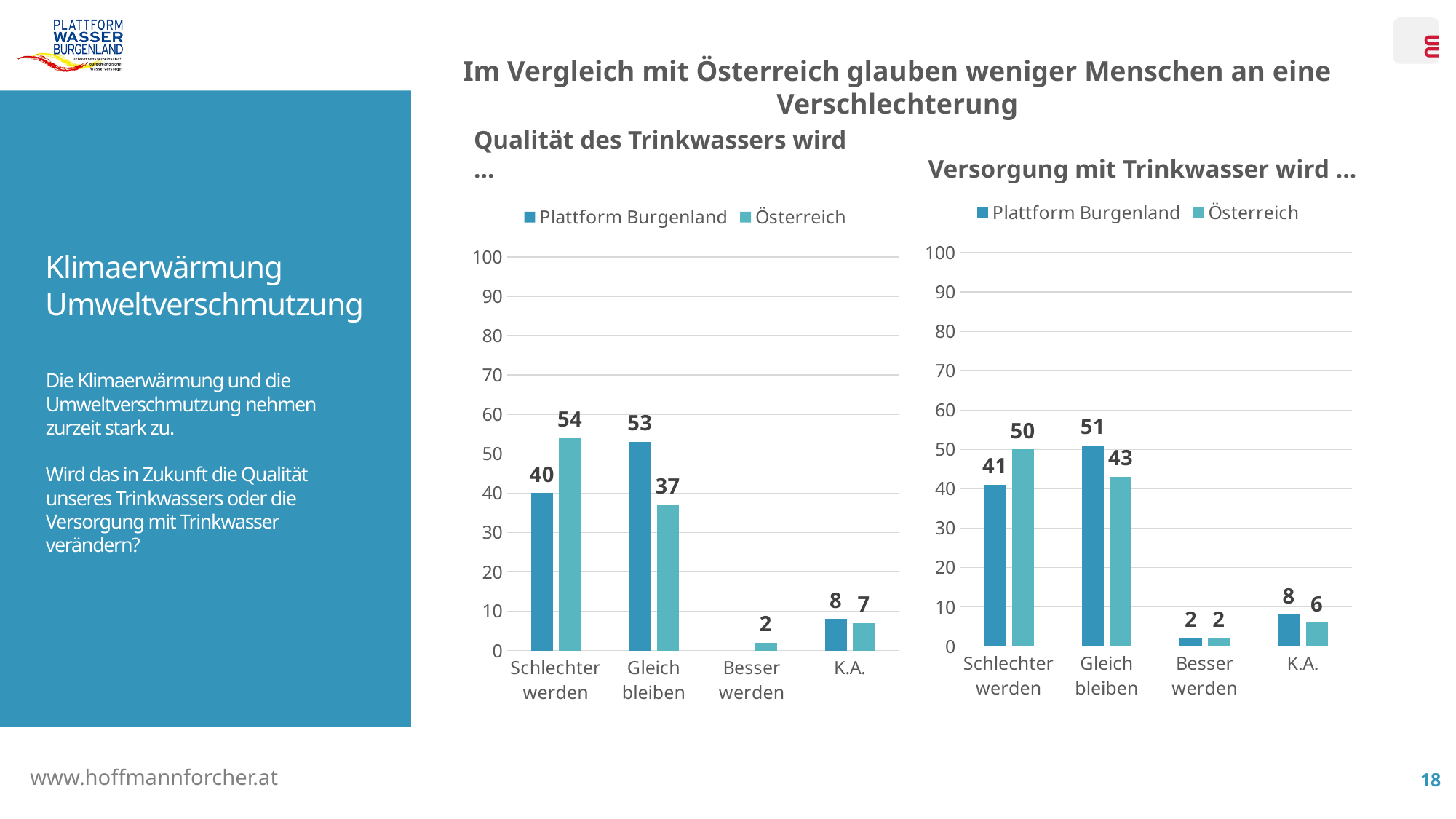
In the chart titled "Qualität des Trinkwassers wird ...", which category has the highest value for Österreich? Schlechter werden How many series does the legend of the chart titled "Versorgung mit Trinkwasser wird ..." list? 2 In the chart titled "Qualität des Trinkwassers wird ...", which is larger for "Gleich bleiben": Plattform Burgenland or Österreich? Plattform Burgenland What kind of chart is the chart titled "Versorgung mit Trinkwasser wird ..."? Bar chart In the chart titled "Qualität des Trinkwassers wird ...", what is the value for Plattform Burgenland in the "Schlechter werden" category? 40 In the chart titled "Versorgung mit Trinkwasser wird ...", what is the value for Österreich in the "Schlechter werden" category? 50 In the chart titled "Versorgung mit Trinkwasser wird ...", what is the difference between the Plattform Burgenland and Österreich values for "Gleich bleiben"? 8 In the chart titled "Versorgung mit Trinkwasser wird ...", which category has the lowest value for Plattform Burgenland? Besser werden In the chart titled "Qualität des Trinkwassers wird ...", what is the value for Österreich in the "Gleich bleiben" category? 37 How many categories are shown on the x axis of the chart titled "Qualität des Trinkwassers wird ..."? 4 In the chart titled "Qualität des Trinkwassers wird ...", what is the difference between the Österreich and Plattform Burgenland values for "Schlechter werden"? 14 In the chart titled "Versorgung mit Trinkwasser wird ...", what is the value for Plattform Burgenland in the "K.A." category? 8